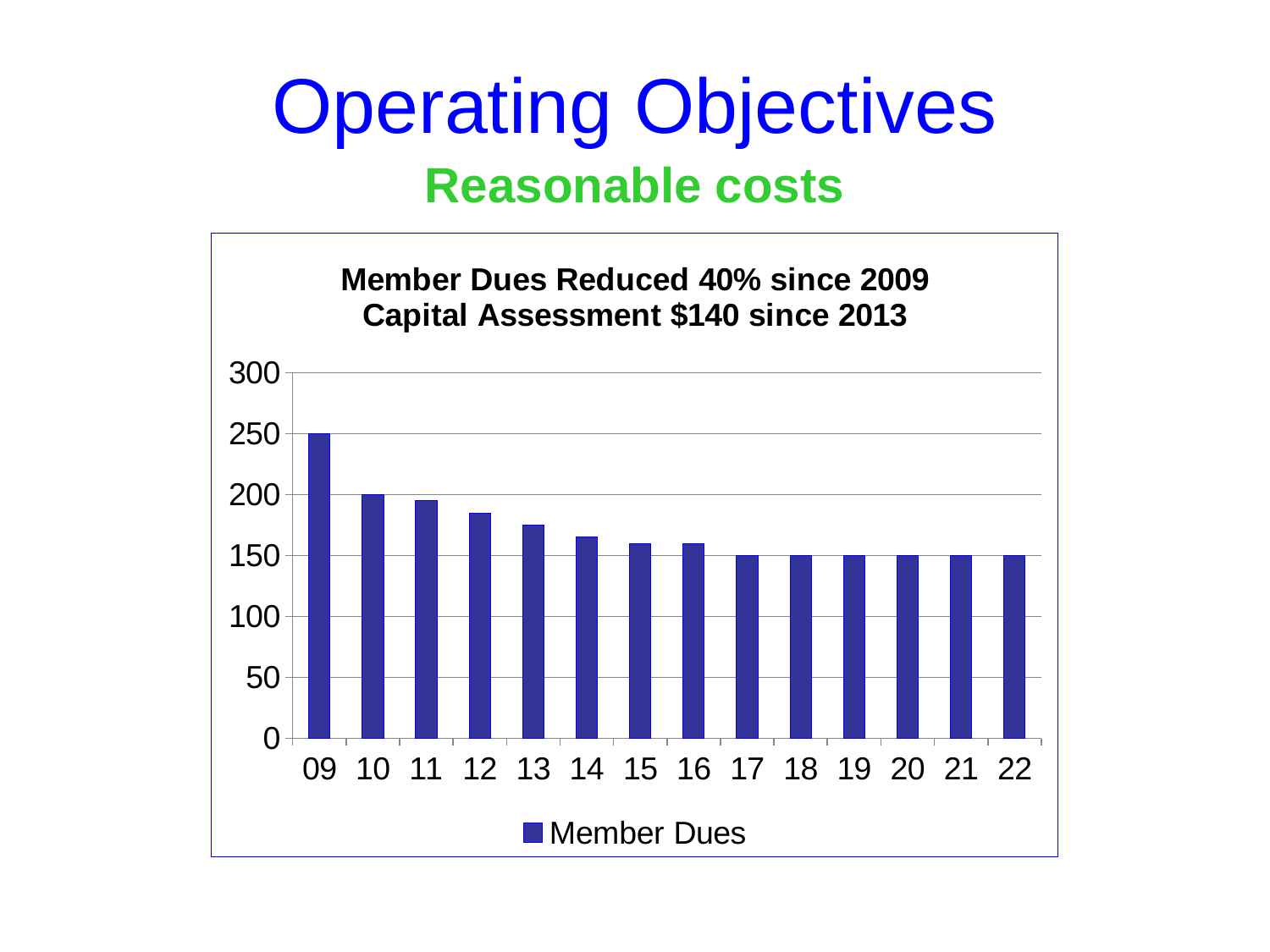
Do Member Dues rise or fall from 09 to 22? Fall How many years are shown on the x axis? 14 Is the value for 14 greater or less than 150? greater What is the value of Member Dues for 09? 250 Is the value for 13 greater or less than 200? less What type of chart is shown on the slide? Bar chart What is the value of Member Dues for 22? 150 What is the value of Member Dues for 10? 200 What is the difference between Member Dues in 09 and 22? 100 Which year has the highest Member Dues? 09 What is the difference between Member Dues in 09 and 10? 50 Which is larger, Member Dues in 11 or in 15? 11